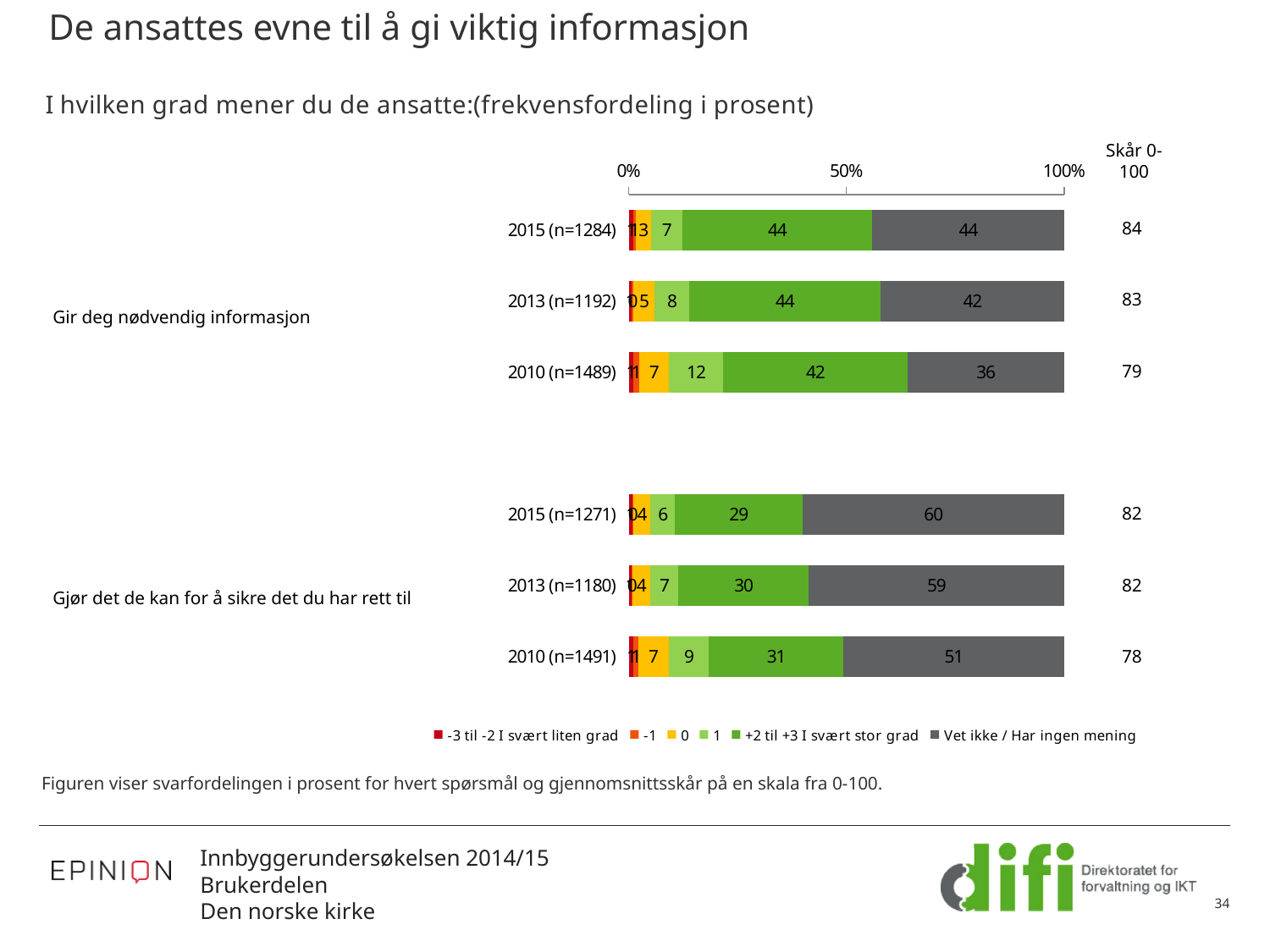
In the "Gjør det de kan for å sikre det du har rett til" group, what percentage answered "Vet ikke / Har ingen mening" in 2015 (n=1271)? 60 What kind of chart is shown on the slide? Stacked bar chart In the "Gir deg nødvendig informasjon" group, what percentage answered "+2 til +3 I svært stor grad" in 2010 (n=1489)? 42 In the "Gjør det de kan for å sikre det du har rett til" group, what is the difference between the "Vet ikke / Har ingen mening" percentage in 2015 (n=1271) and in 2010 (n=1491)? 9 Which year has the lowest Skår 0-100 value in the "Gjør det de kan for å sikre det du har rett til" group? 2010 (n=1491) In the "Gjør det de kan for å sikre det du har rett til" group, which year has the larger "+2 til +3 I svært stor grad" percentage: 2013 (n=1180) or 2010 (n=1491)? 2010 (n=1491) How many bars are plotted in the chart in total? 6 What is the Skår 0-100 value for 2010 (n=1491) under "Gjør det de kan for å sikre det du har rett til"? 78 Which year has the highest Skår 0-100 value in the "Gir deg nødvendig informasjon" group? 2015 (n=1284) How many series does the legend list? 6 In the "Gir deg nødvendig informasjon" group, what percentage answered "1" in 2010 (n=1489)? 12 What is the Skår 0-100 value for 2015 (n=1284) under "Gir deg nødvendig informasjon"? 84